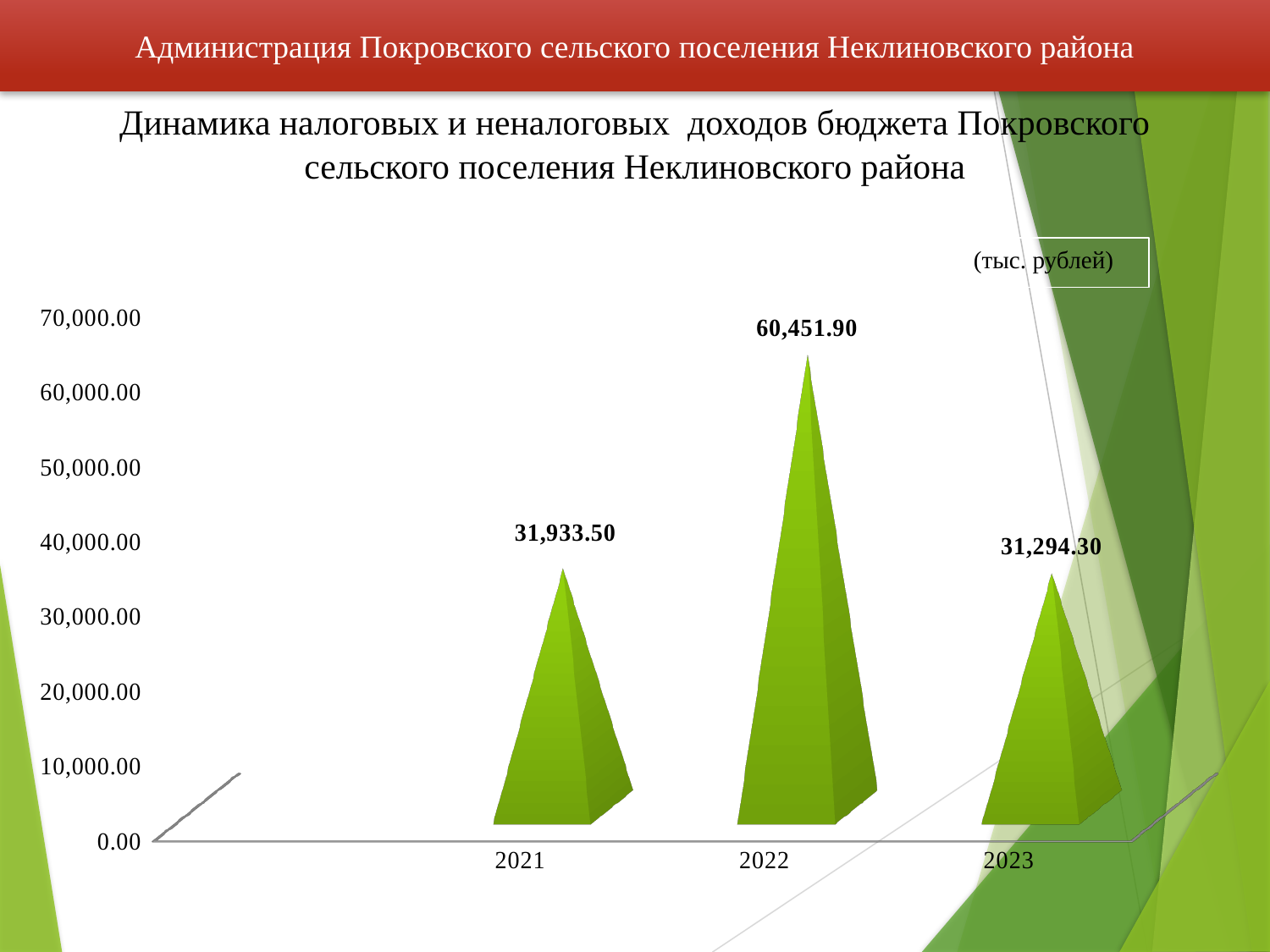
Which year has the lowest value? 2023 What is the value for 2023? 31,294.30 What is the value for 2021? 31,933.50 What is the difference between the values for 2022 and 2021? 28,518.40 Is the value for 2022 greater or less than 50,000.00? greater What is the value for 2022? 60,451.90 Which year has the highest value? 2022 In what units are the values on the chart given? тыс. рублей What is the difference between the values for 2021 and 2023? 639.20 Which is larger, the value for 2021 or the value for 2023? 2021 What kind of chart is shown on the slide? bar chart How many years are shown on the x axis? 3